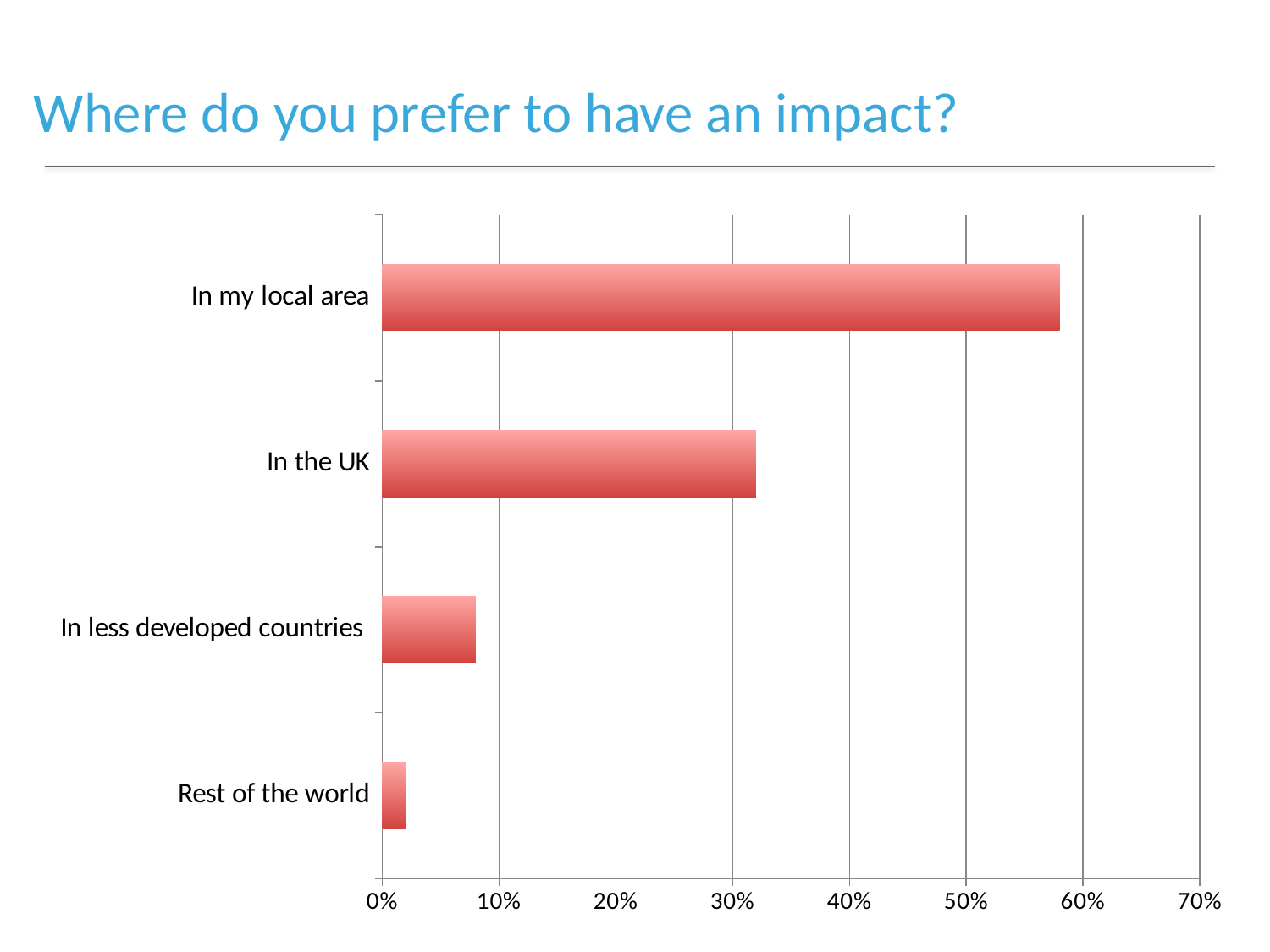
Which is larger, the value for In my local area or the value for In the UK? In my local area Which is larger, the value for In the UK or the value for In less developed countries? In the UK Is the value for Rest of the world greater or less than 10%? less Which category has the lowest value? Rest of the world How many categories are shown in the chart? 4 Is the value for In my local area greater or less than 50%? greater What is the title of the slide? Where do you prefer to have an impact? Which category has the highest value? In my local area What kind of chart is shown on the slide? Bar chart Is the value for In less developed countries greater or less than 10%? less What is the highest value shown on the x axis? 70%